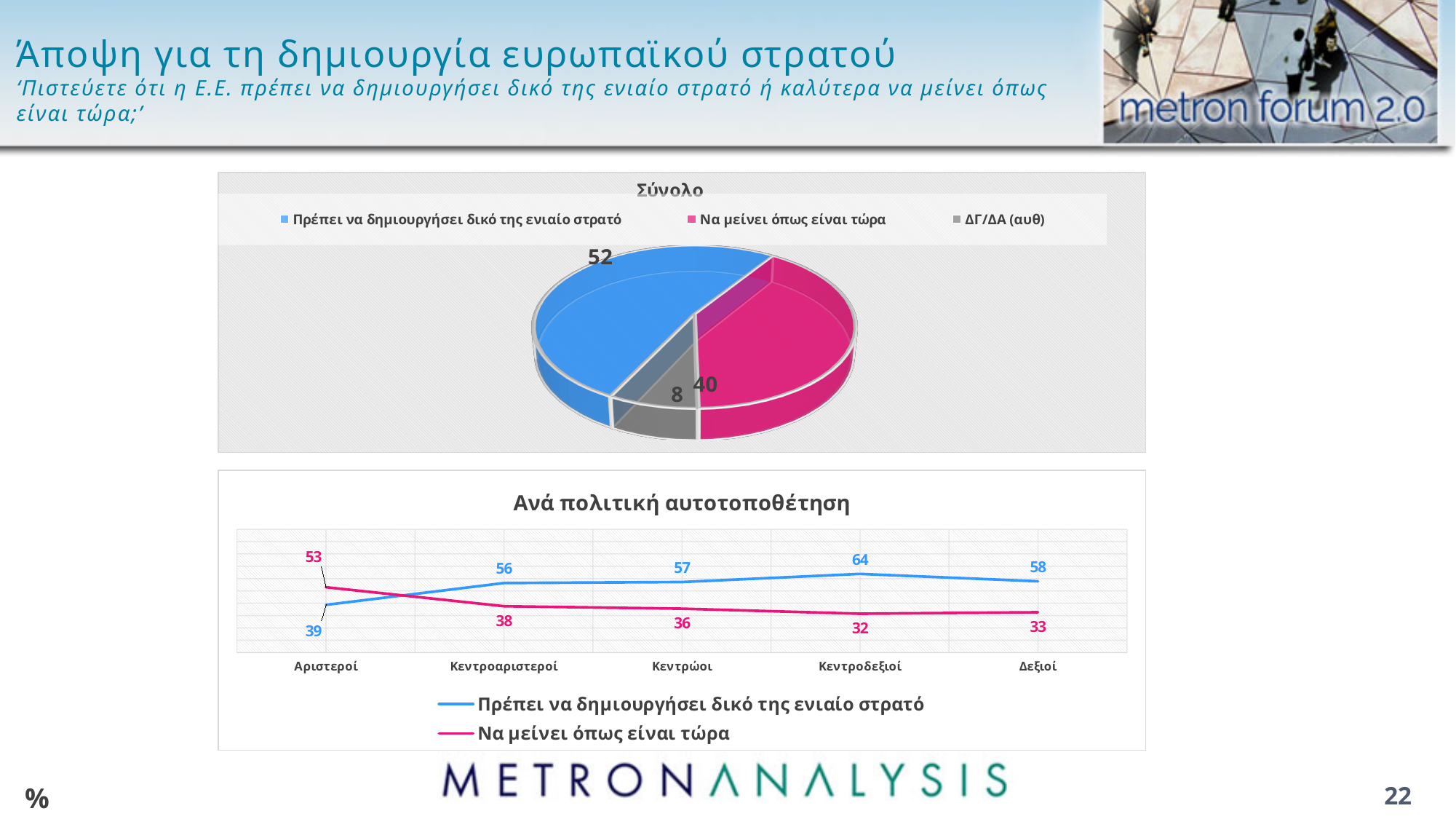
In the 'Σύνολο' pie chart, what is the difference between 'Πρέπει να δημιουργήσει δικό της ενιαίο στρατό' and 'Να μείνει όπως είναι τώρα'? 12 In the 'Ανά πολιτική αυτοτοποθέτηση' chart, what is the value for 'Να μείνει όπως είναι τώρα' at 'Αριστεροί'? 53 In the 'Ανά πολιτική αυτοτοποθέτηση' chart, which category has the lowest value for 'Να μείνει όπως είναι τώρα'? Κεντροδεξιοί In the 'Σύνολο' pie chart, what is the value for 'ΔΓ/ΔΑ (αυθ)'? 8 In the 'Ανά πολιτική αυτοτοποθέτηση' chart, at 'Αριστεροί', which series has the larger value? Να μείνει όπως είναι τώρα How many series does the legend of the 'Ανά πολιτική αυτοτοποθέτηση' chart list? 2 What kind of chart is the 'Σύνολο' chart? Pie chart How many categories are shown on the x axis of the 'Ανά πολιτική αυτοτοποθέτηση' chart? 5 In the 'Ανά πολιτική αυτοτοποθέτηση' chart, what is the value for 'Πρέπει να δημιουργήσει δικό της ενιαίο στρατό' at 'Κεντροδεξιοί'? 64 In the 'Ανά πολιτική αυτοτοποθέτηση' chart, which category has the highest value for 'Πρέπει να δημιουργήσει δικό της ενιαίο στρατό'? Κεντροδεξιοί In the 'Σύνολο' pie chart, which category has the smallest slice? ΔΓ/ΔΑ (αυθ) In the 'Σύνολο' pie chart, what is the value for 'Πρέπει να δημιουργήσει δικό της ενιαίο στρατό'? 52